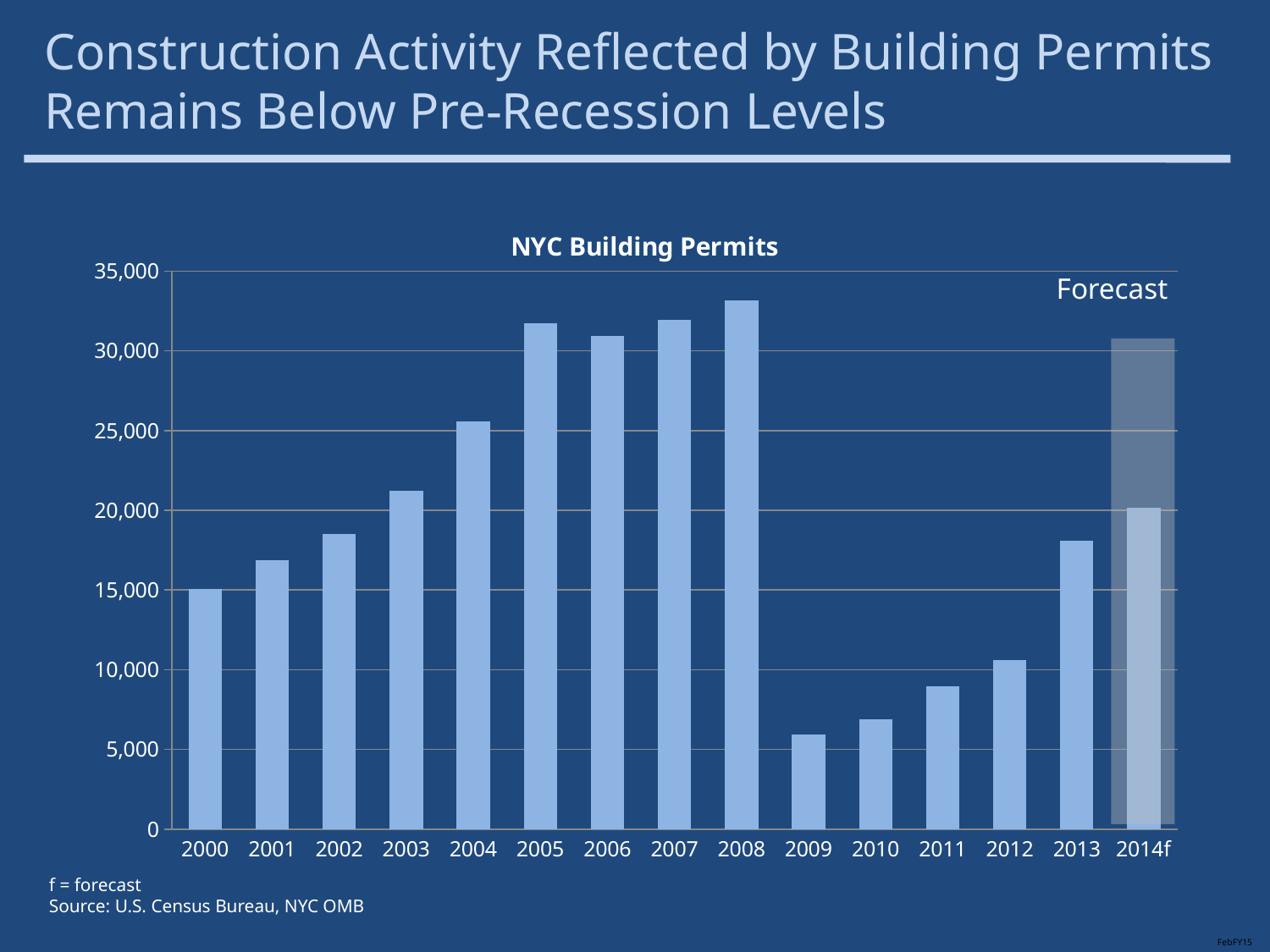
Is the value for 2014f greater or less than 25,000? less Which year has the highest number of NYC building permits? 2008 Which bar on the chart is marked as a forecast? 2014f How many years (bars) are shown on the x axis of the chart? 15 Do the values rise or fall from 2000 to 2008? rise Which year has more building permits, 2004 or 2013? 2004 What kind of chart is shown on the slide? bar chart Which year has the lowest number of NYC building permits? 2009 Is the value for 2013 greater or less than 20,000? less Is the value for 2012 greater or less than 10,000? greater What is the title of the chart? NYC Building Permits